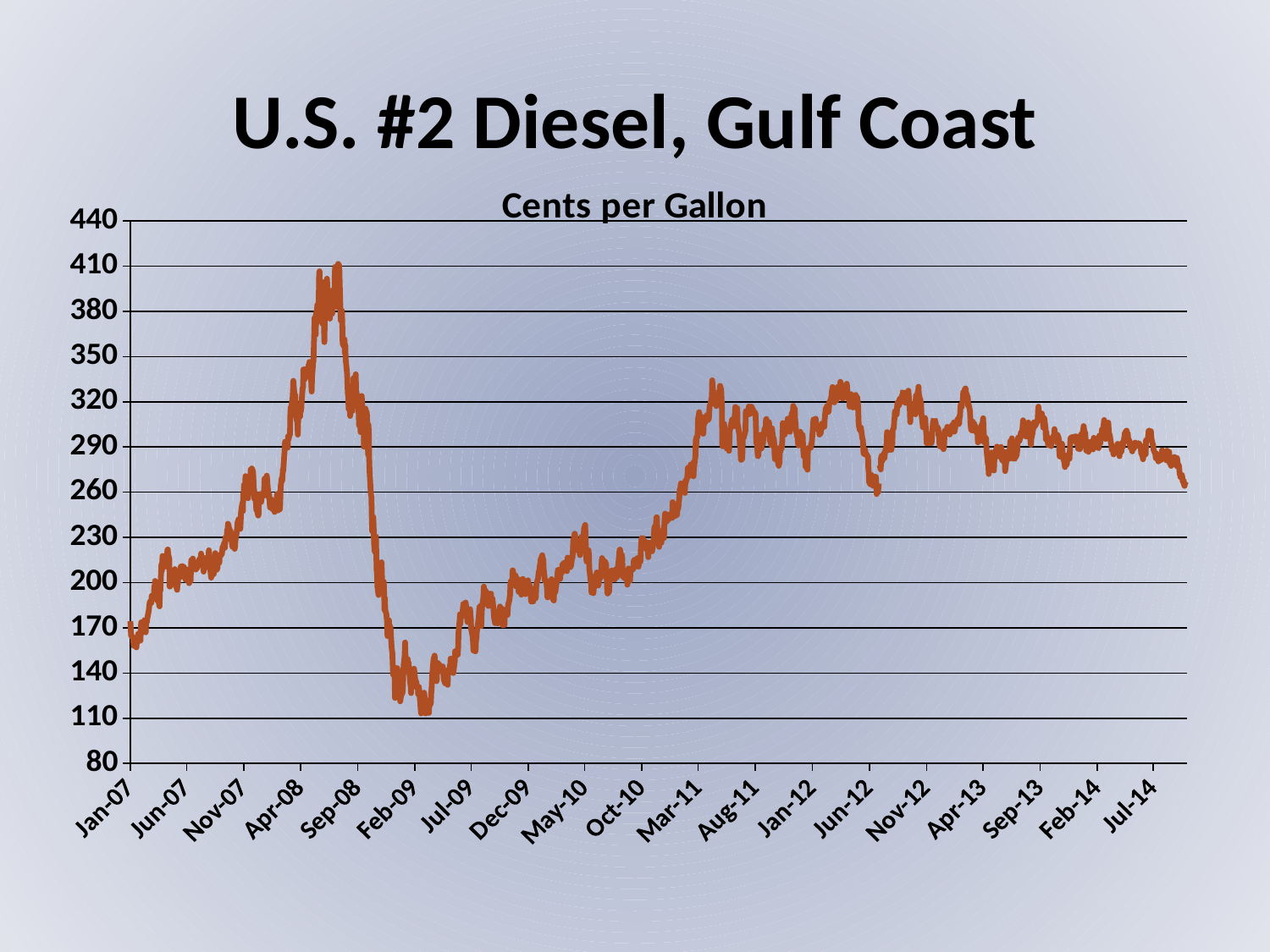
Is the peak value reached in mid-2008 greater or less than 380? greater Around which x-axis label does the line reach its lowest point? Feb-09 How many date labels are shown along the x axis? 19 Around which x-axis label does the line reach its highest point? Sep-08 Is the value at Jul-14 greater or less than 260? greater What unit is the chart's subtitle stated in? Cents per Gallon Is the value at Jul-09 greater or less than 200? less What kind of chart is shown on the slide? line chart What is the title of the chart? U.S. #2 Diesel, Gulf Coast Does the line rise or fall between Sep-08 and Feb-09? fall